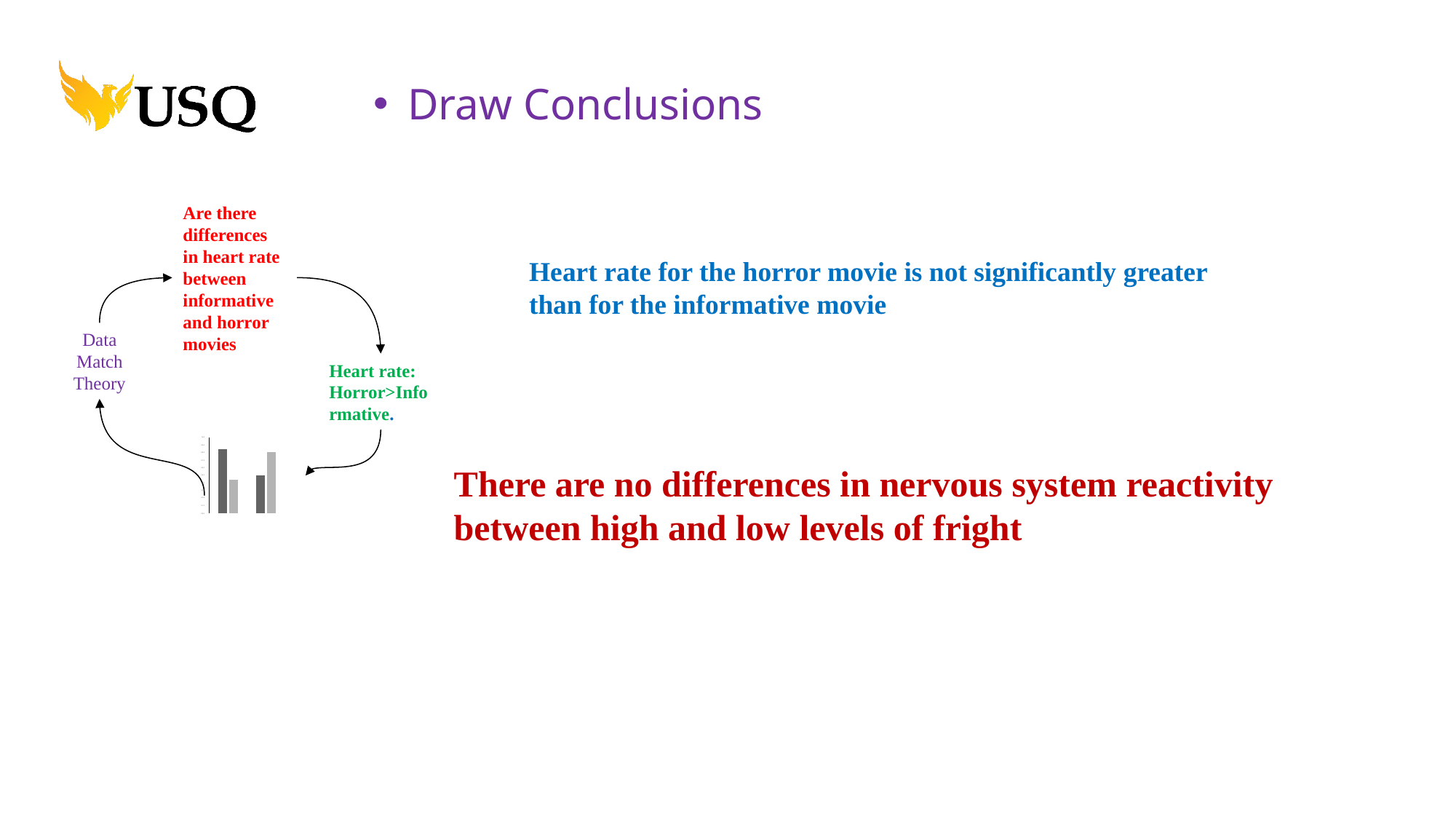
In the small bar chart at the bottom left, which bar is the shortest: the first, second, third or fourth? second In the small bar chart at the bottom left, is the fourth (rightmost) bar taller or shorter than the third bar? taller What kind of chart is shown in the small diagram at the bottom left of the slide? bar chart In the small bar chart at the bottom left, which bar is the tallest: the first, second, third or fourth? first How many bars does the small bar chart at the bottom left of the slide contain? 4 In the small bar chart at the bottom left, is the first (leftmost) bar taller or shorter than the second bar? taller Does the small bar chart at the bottom left of the slide have a visible title? No How many different shades of grey are used for the bars in the small bar chart at the bottom left? 2